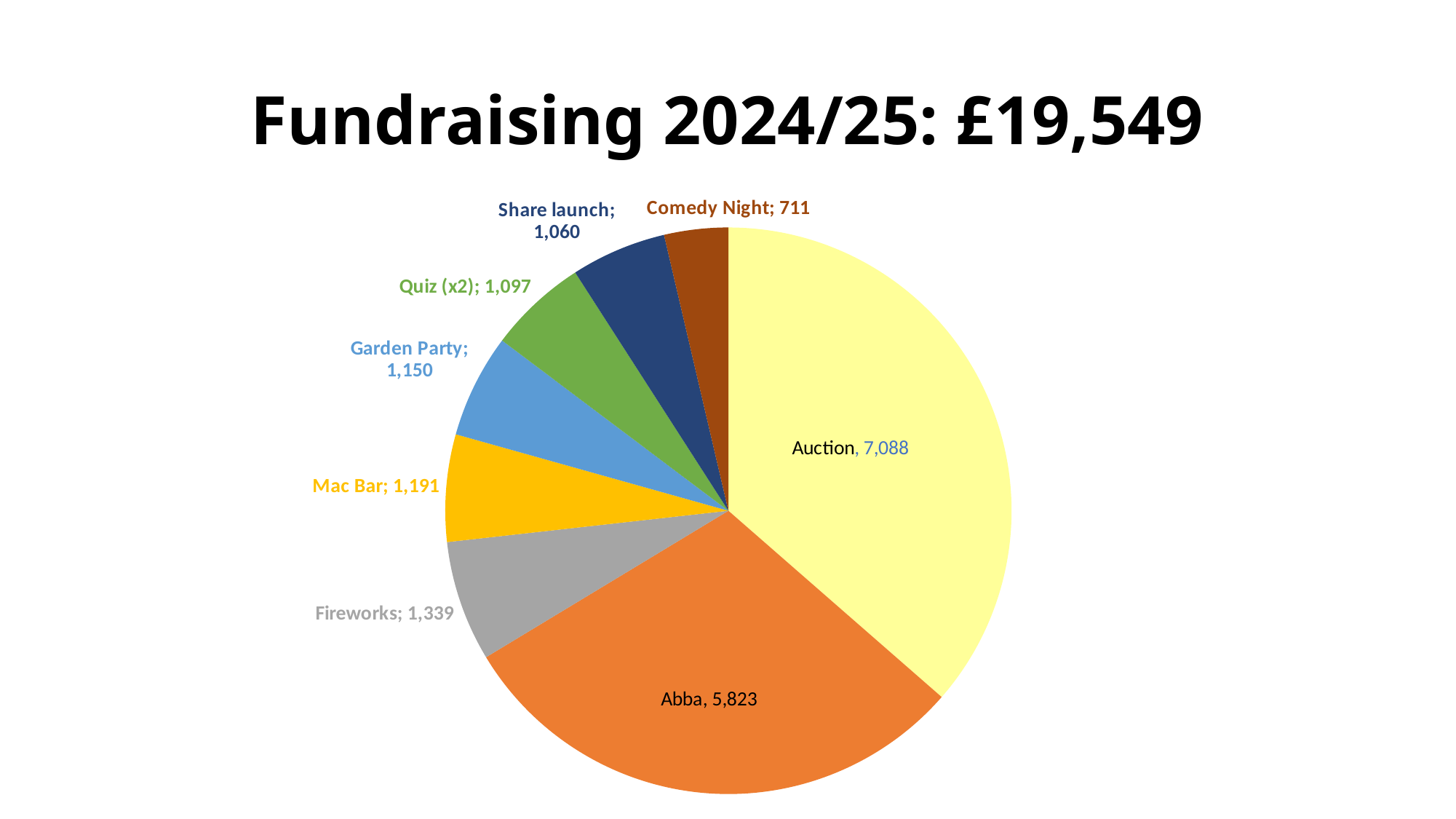
What is the difference between the values for Auction and Abba? 1,265 What is the value for Auction? 7,088 What is the title of the slide? Fundraising 2024/25: £19,549 Which category has the largest slice? Auction Which category has the smallest slice? Comedy Night What kind of chart is shown on the slide? Pie chart What is the difference between the values for Share launch and Comedy Night? 349 What is the value for Fireworks? 1,339 What is the value for Comedy Night? 711 Which is larger, the value for Fireworks or the value for Mac Bar? Fireworks What is the value for Abba? 5,823 How many slices does the pie chart have? 8